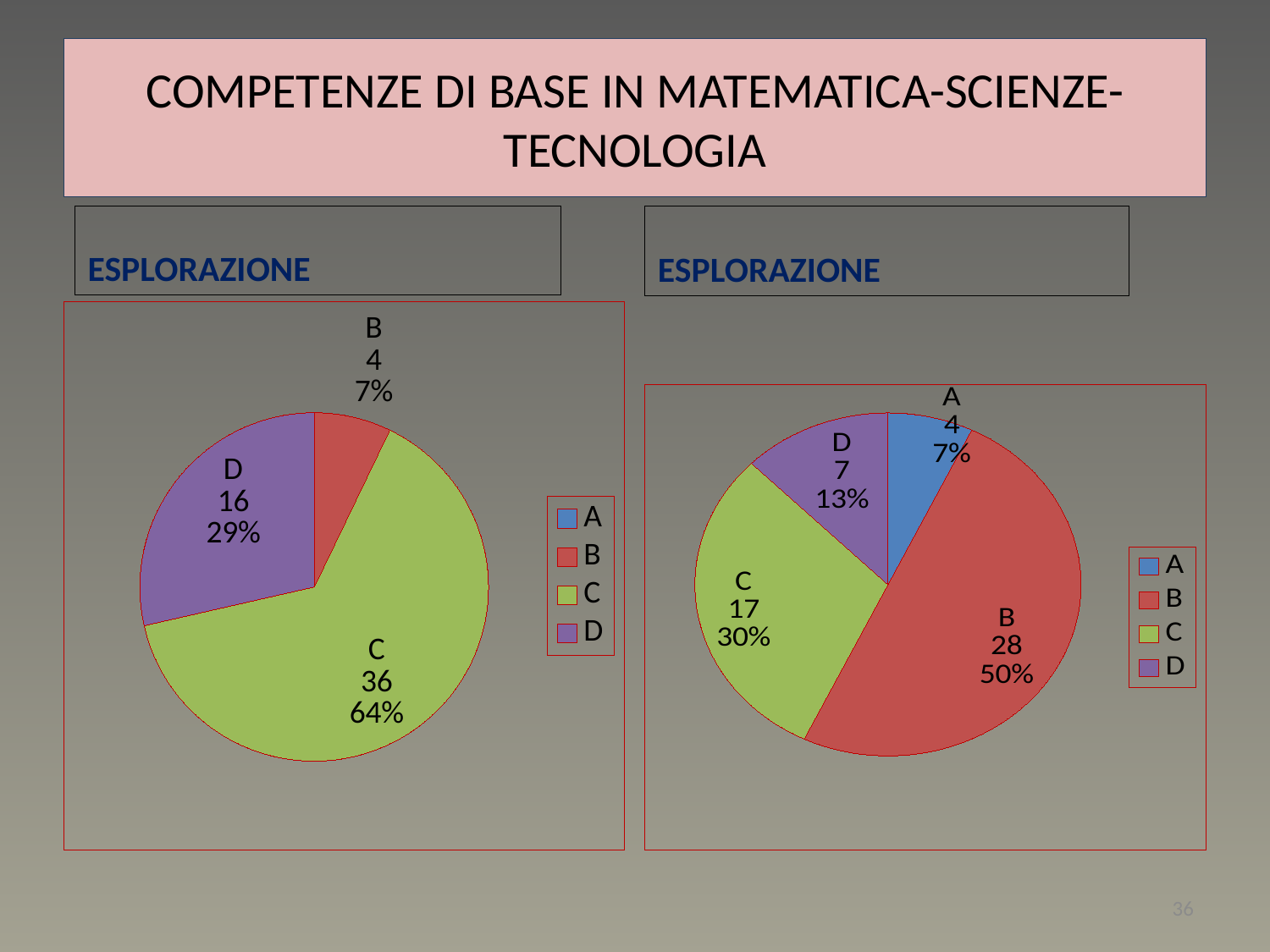
In the left pie chart, what percentage share does category D have? 29% In the right pie chart, which is larger, the value for C or the value for D? C In the left pie chart, what value is shown for category C? 36 In the right pie chart, which category has the smallest slice? A In the left pie chart, what is the difference between the values for C and D? 20 What type of chart is shown on the left side of the slide? Pie chart In the right pie chart, what value is shown for category B? 28 In the right pie chart, which category has the largest slice? B How many slices does the right pie chart have? 4 In the left pie chart, which category has the largest slice? C In the right pie chart, what percentage share does category C have? 30% In the left pie chart, which labelled category has the smallest slice? B